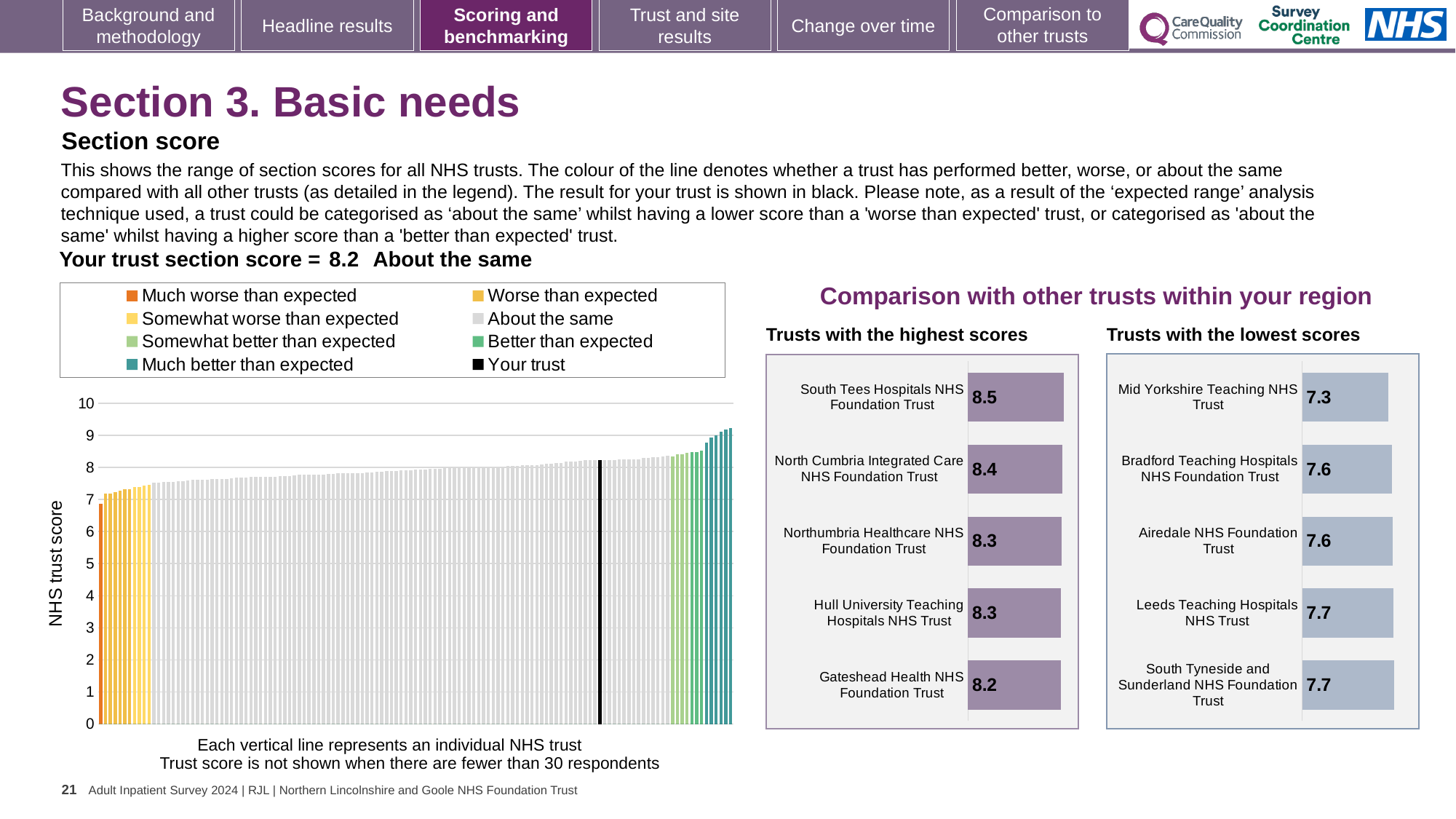
How many entries does the legend above the large chart on the left list? 8 On the large chart on the left, what is the section score for your trust (the black bar)? 8.2 On the large chart on the left, is the value of the tallest bar greater or less than 9? greater In the 'Trusts with the highest scores' chart, how many trusts are shown? 5 In the 'Trusts with the highest scores' chart, which trust has the highest score? South Tees Hospitals NHS Foundation Trust In the 'Trusts with the lowest scores' chart, which has the larger score: Bradford Teaching Hospitals NHS Foundation Trust or Leeds Teaching Hospitals NHS Trust? Leeds Teaching Hospitals NHS Trust On the large chart on the left, what is the label of the vertical axis? NHS trust score In the 'Trusts with the highest scores' chart, what is the difference between the scores of South Tees Hospitals NHS Foundation Trust and Gateshead Health NHS Foundation Trust? 0.3 In the 'Trusts with the lowest scores' chart, what is the score for Airedale NHS Foundation Trust? 7.6 In the 'Trusts with the highest scores' chart, what is the score for North Cumbria Integrated Care NHS Foundation Trust? 8.4 What kind of chart is the large chart on the left showing NHS trust scores? bar chart In the 'Trusts with the lowest scores' chart, which trust has the lowest score? Mid Yorkshire Teaching NHS Trust